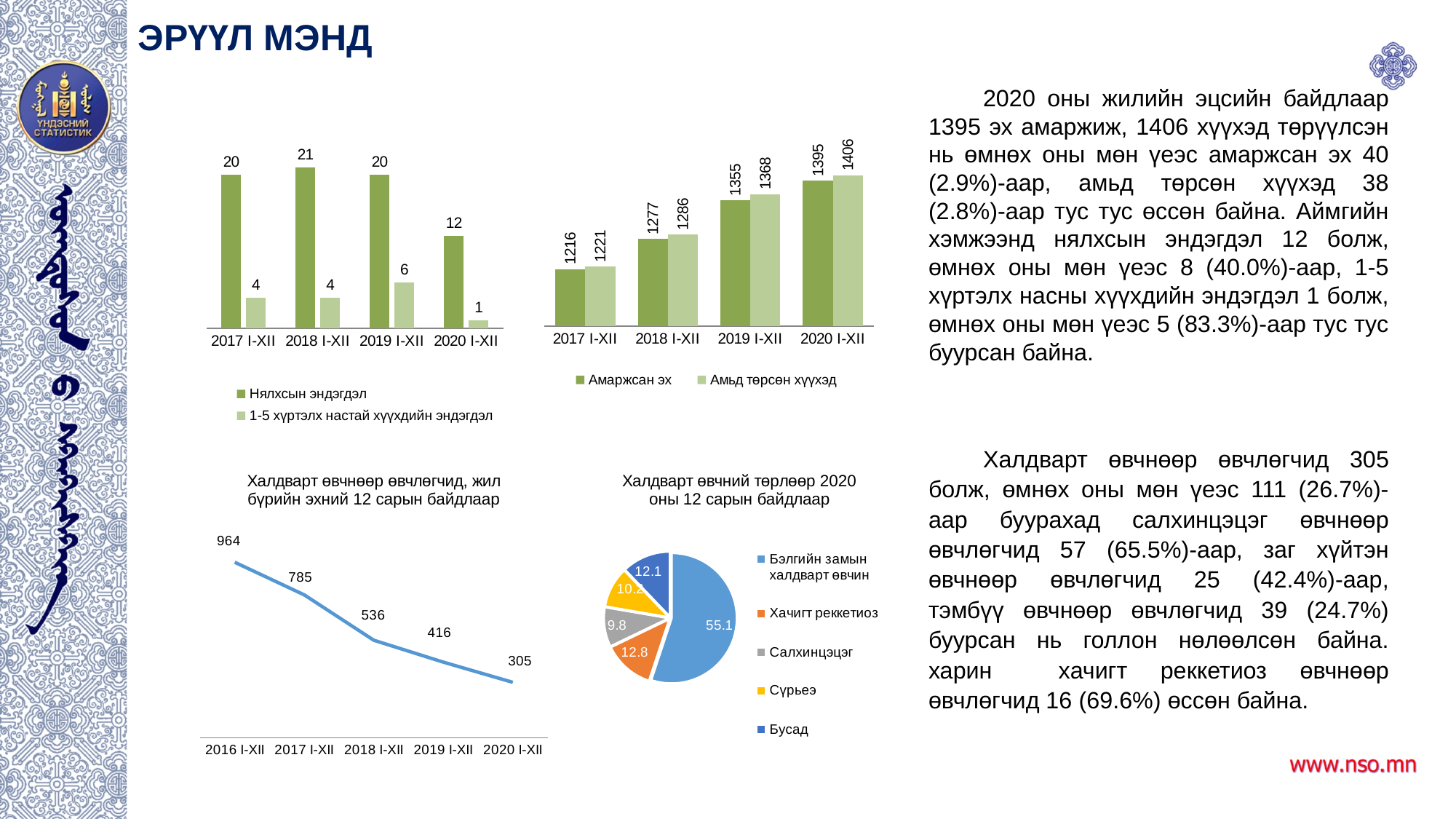
In the top-left bar chart, what is the difference between Нялхсын эндэгдэл in 2019 I-XII and 2020 I-XII? 8 In the chart titled 'Халдварт өвчнөөр өвчлөгчид, жил бүрийн эхний 12 сарын байдлаар', what is the value for 2018 I-XII? 536 In the top-left bar chart, what is the value for Нялхсын эндэгдэл in 2018 I-XII? 21 In the chart titled 'Халдварт өвчнөөр өвчлөгчид, жил бүрийн эхний 12 сарын байдлаар', what is the difference between the 2016 I-XII and 2020 I-XII values? 659 What kind of chart is 'Халдварт өвчнөөр өвчлөгчид, жил бүрийн эхний 12 сарын байдлаар'? line chart In the top-right bar chart, do the values for Амаржсан эх rise or fall from 2017 I-XII to 2020 I-XII? rise In the pie chart titled 'Халдварт өвчний төрлөөр 2020 оны 12 сарын байдлаар', what is the share of Бэлгийн замын халдварт өвчин? 55.1 In the top-right bar chart, what is the value for Амьд төрсөн хүүхэд in 2019 I-XII? 1368 In the top-left bar chart, what is the value for 1-5 хүртэлх настай хүүхдийн эндэгдэл in 2020 I-XII? 1 In the top-left bar chart, which year has the highest value for 1-5 хүртэлх настай хүүхдийн эндэгдэл? 2019 I-XII In the top-right bar chart, how many series does the legend list? 2 In the top-right bar chart, which year has the lowest value for Амаржсан эх? 2017 I-XII